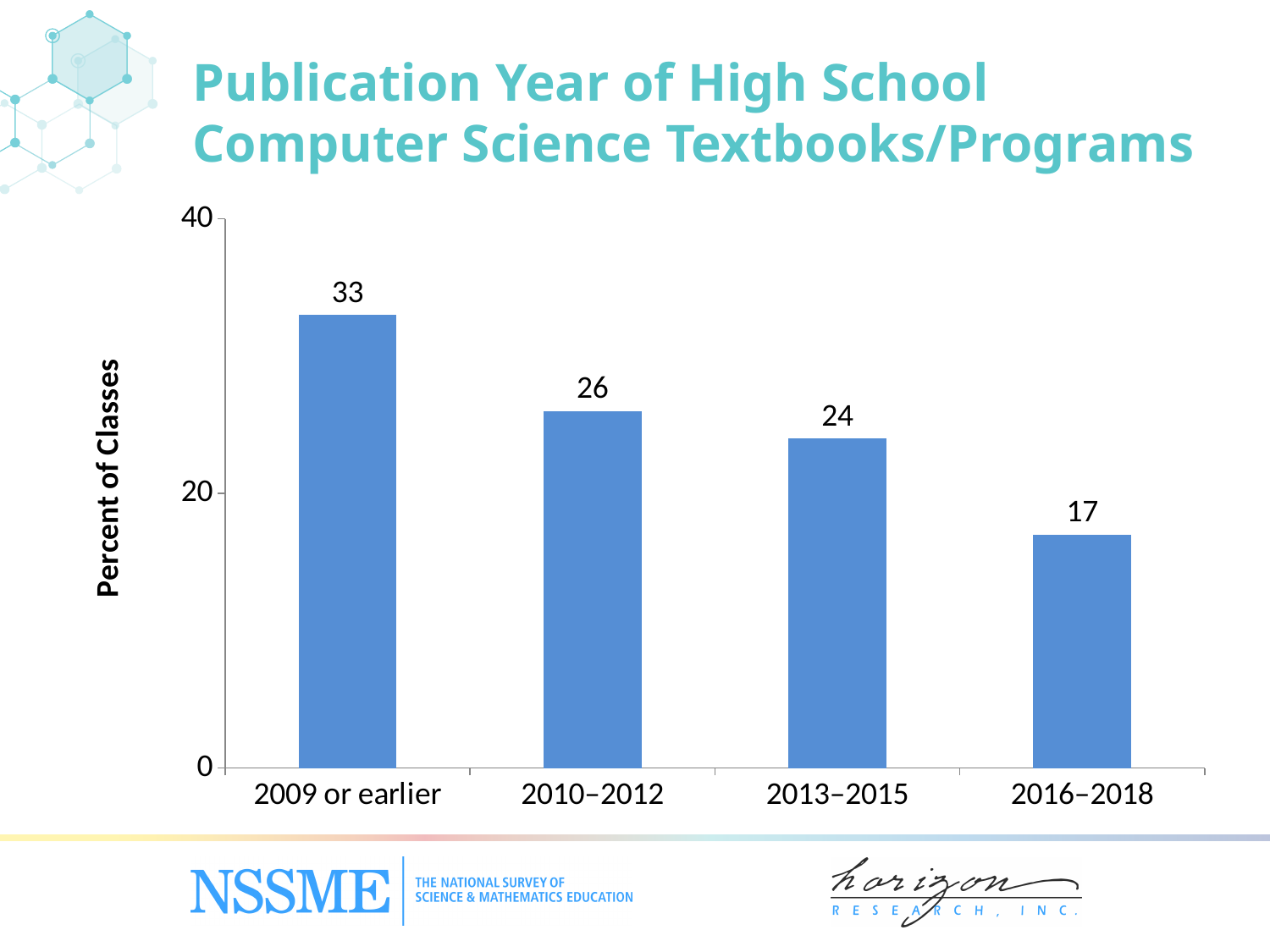
What is the value for the 2016–2018 category? 17 Which publication year category has the highest percent of classes? 2009 or earlier What is the value for the 2010–2012 category? 26 What is the difference between the values for 2009 or earlier and 2016–2018? 16 How many publication year categories are shown on the chart? 4 Which publication year category has the lowest percent of classes? 2016–2018 Do the values rise or fall moving from left to right along the x axis? fall What percent of classes use textbooks/programs published in 2009 or earlier? 33 What kind of chart is shown on the slide? bar chart What is the value for the 2013–2015 category? 24 Is the value for 2016–2018 greater or less than 20? less Which is larger, the value for 2010–2012 or the value for 2013–2015? 2010–2012